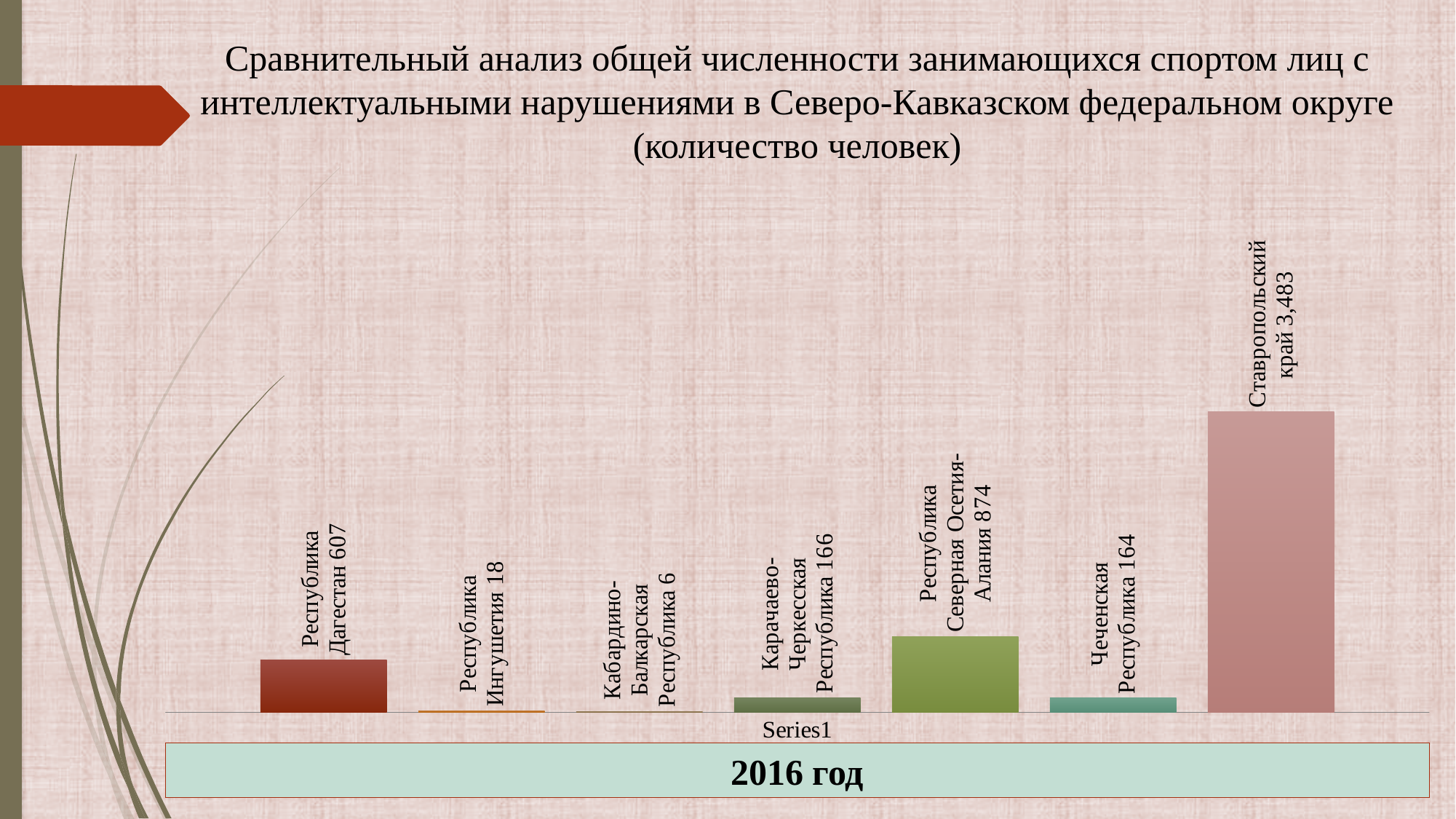
What is the value for Республика Северная Осетия-Алания? 874 Which is larger, the value for Карачаево-Черкесская Республика or the value for Чеченская Республика? Карачаево-Черкесская Республика What year is indicated below the chart? 2016 год How many regions are shown in the chart? 7 What is the difference between the values for Республика Ингушетия and Кабардино-Балкарская Республика? 12 What is the difference between the values for Республика Северная Осетия-Алания and Республика Дагестан? 267 Which region has the highest value? Ставропольский край What is the value for Кабардино-Балкарская Республика? 6 What kind of chart is shown on the slide? Bar chart What is the value for Республика Дагестан? 607 Which region has the lowest value? Кабардино-Балкарская Республика What is the value for Ставропольский край? 3,483